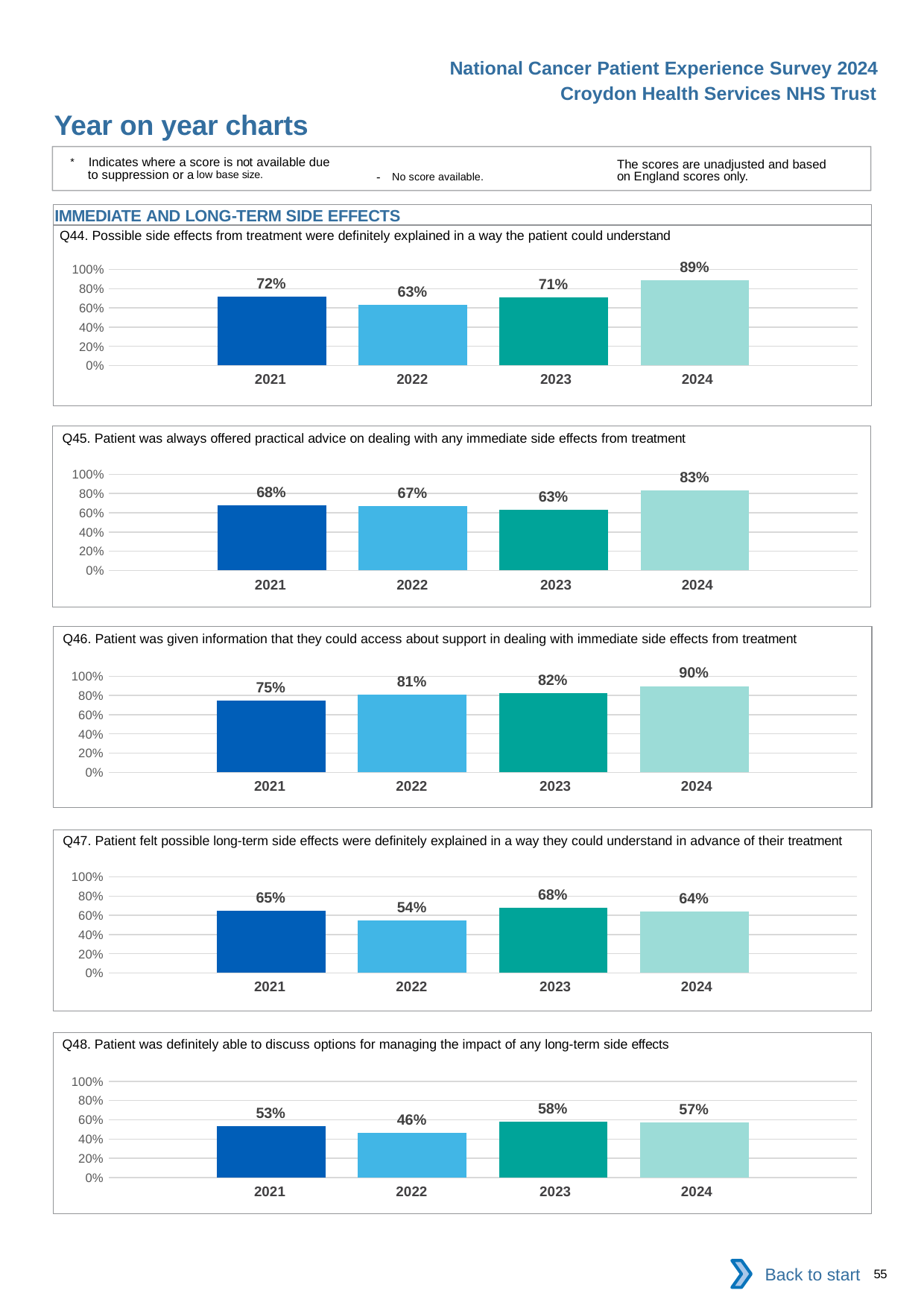
In the Q44 chart, what is the value for 2024? 89% What is the section heading above the Q44 chart? IMMEDIATE AND LONG-TERM SIDE EFFECTS In the Q48 chart, is the value for 2021 greater or less than 60%? less In the Q44 chart, which is larger, the value for 2021 or the value for 2022? 2021 In the Q47 chart, which year has the highest value? 2023 In the Q45 chart, which year has the lowest value? 2023 How many years are plotted in the Q45 chart? 4 In the Q46 chart, what is the difference between the 2024 and 2021 values? 15% In the Q48 chart, what is the value for 2022? 46% In the Q46 chart, do the values rise or fall from 2021 to 2024? rise In the Q47 chart, what is the difference between the 2023 and 2022 values? 14% What kind of chart is the Q46 chart? bar chart